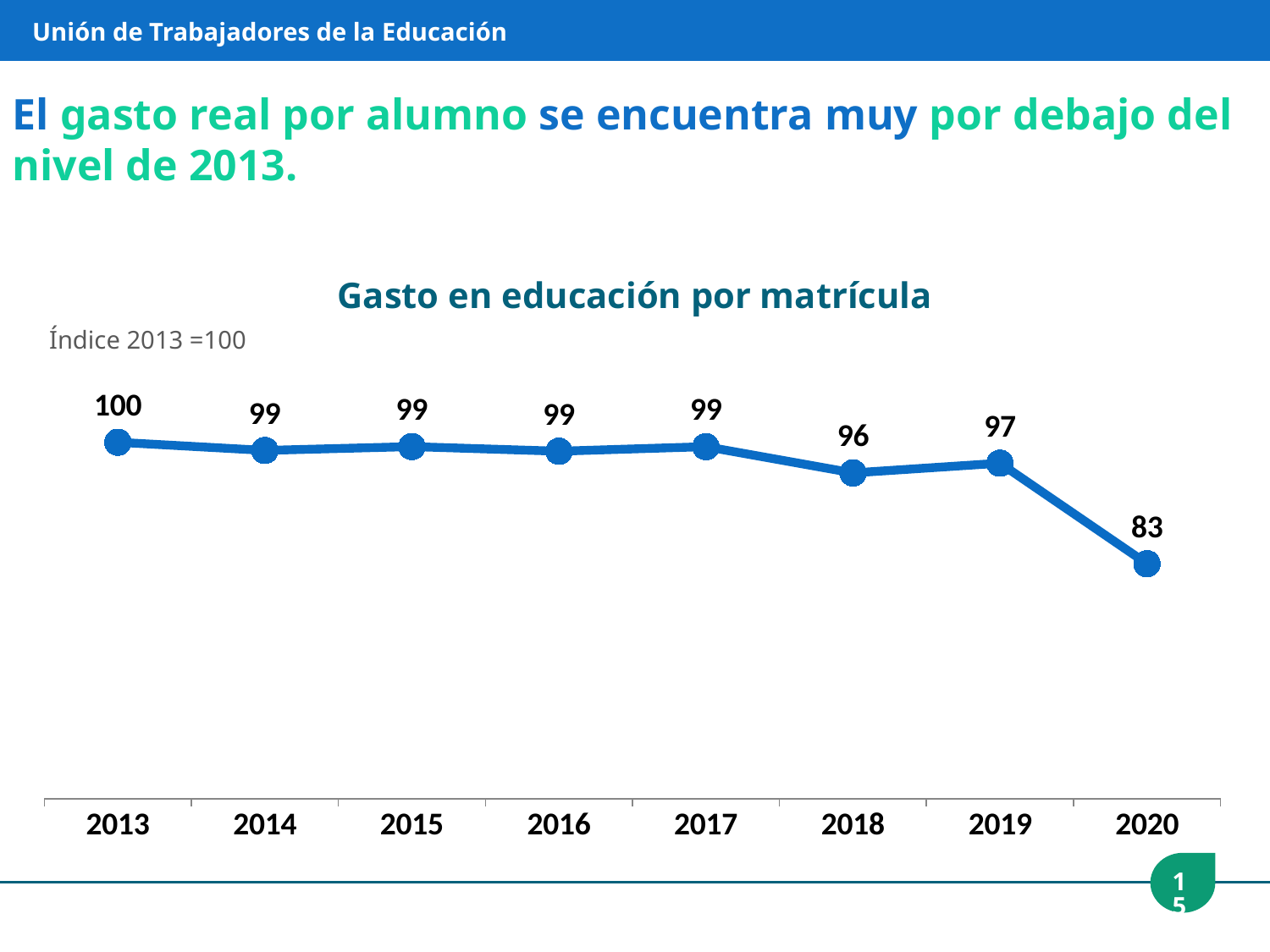
Which year has a larger index value, 2018 or 2019? 2019 What is the title of the chart? Gasto en educación por matrícula How many years are plotted on the chart? 8 What kind of chart is shown? Line chart What is the difference between the index values for 2019 and 2020? 14 What is the difference between the index values for 2013 and 2020? 17 What is the index value for 2020? 83 Which year has the highest index value? 2013 What is the index value for 2019? 97 Which year has the lowest index value? 2020 What is the index value for 2013? 100 What is the index value for 2018? 96